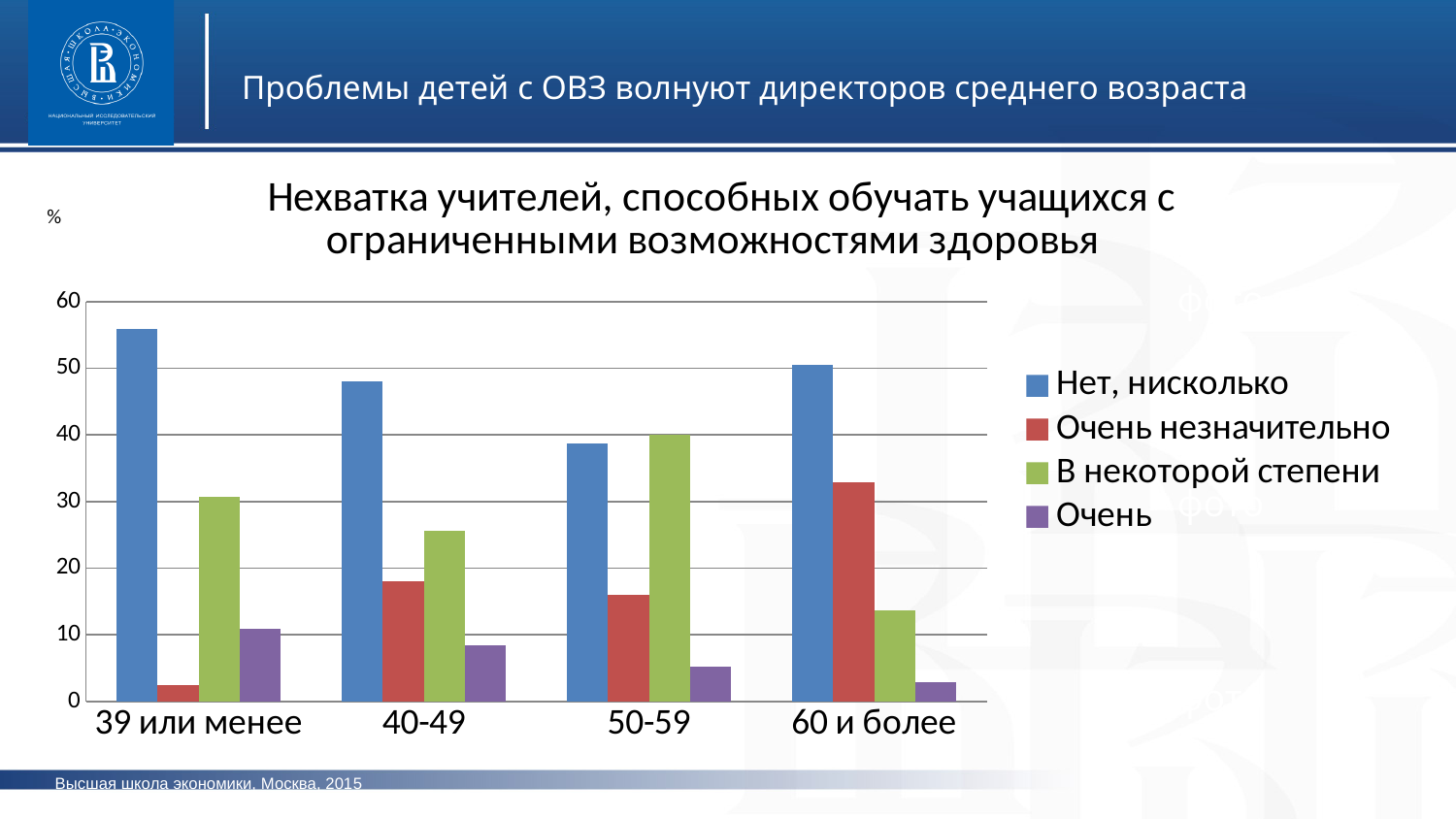
Which age group has the lowest value for "Нет, нисколько"? 50-59 Which age group has the highest value for "Нет, нисколько"? 39 или менее What kind of chart is shown on the slide? bar chart Is the value for "Нет, нисколько" in the "39 или менее" group greater or less than 50? greater How many age-group categories are shown on the x axis? 4 Do the values for "Очень" rise or fall as the age groups go from "39 или менее" to "60 и более"? fall Which is larger: the value for "Очень незначительно" in the "60 и более" group or in the "40-49" group? 60 и более Which age group has the highest value for "Очень незначительно"? 60 и более Which age group has the lowest value for "Очень"? 60 и более Is the value for "В некоторой степени" in the "60 и более" group greater or less than 20? less Is the value for "Очень незначительно" in the "39 или менее" group greater or less than 10? less How many series does the legend list? 4